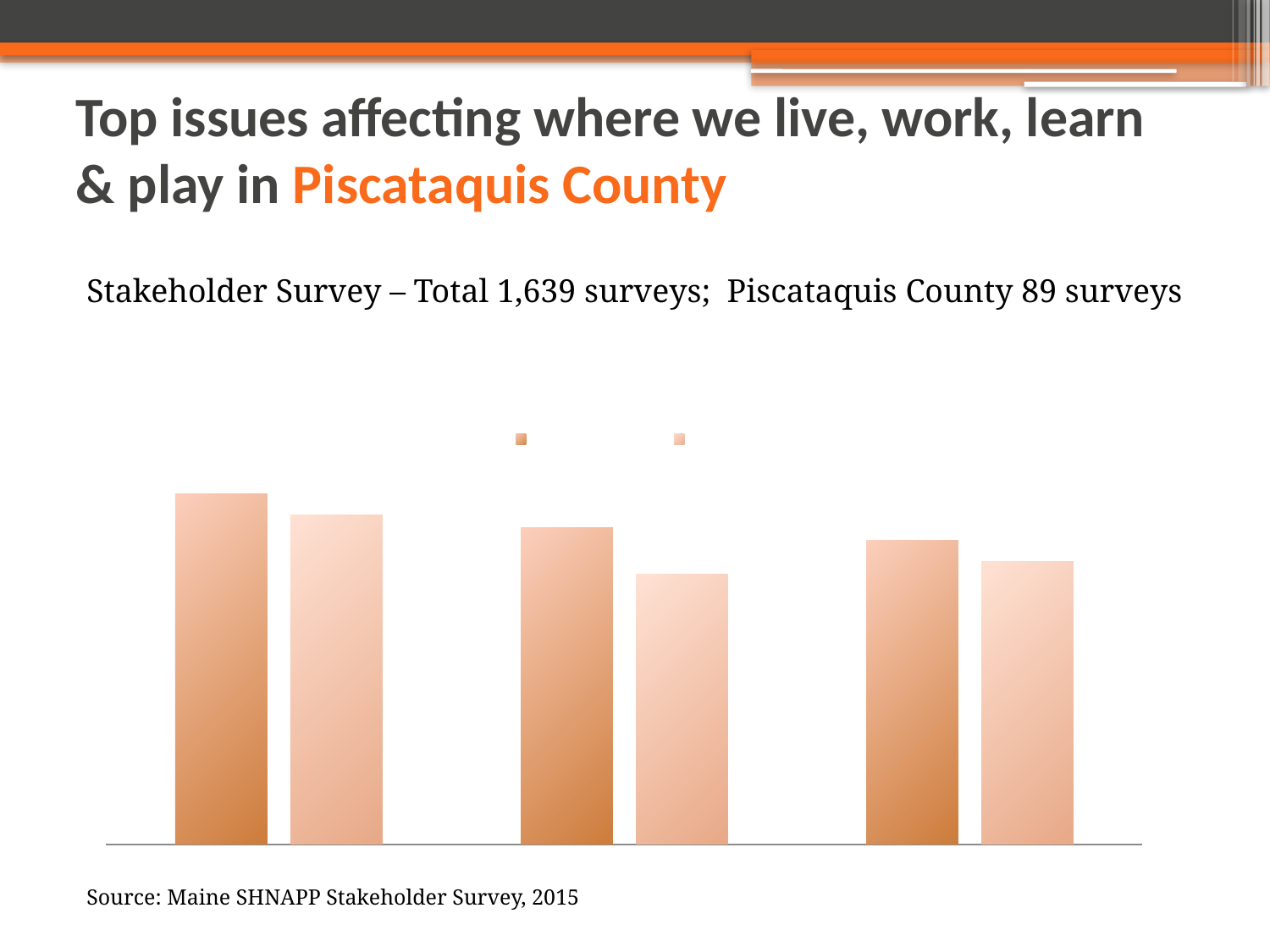
In the leftmost group, is the darker orange bar or the lighter orange bar taller? the darker orange bar Which group of bars, by position, contains the tallest bar in the chart? the leftmost group What kind of chart is shown on the slide? bar chart How many bars are plotted in total in the chart? 6 Do the darker orange bars rise or fall from left to right across the three groups? fall Which group of bars, by position, contains the shortest bar in the chart? the middle group How many groups of bars (categories) are plotted in the chart? 3 How many series does the chart's legend list? 2 In the middle group, is the darker orange bar or the lighter orange bar taller? the darker orange bar Is the darker orange bar in the leftmost group taller or shorter than the darker orange bar in the rightmost group? taller What colours are the two series in the chart? darker orange and lighter orange